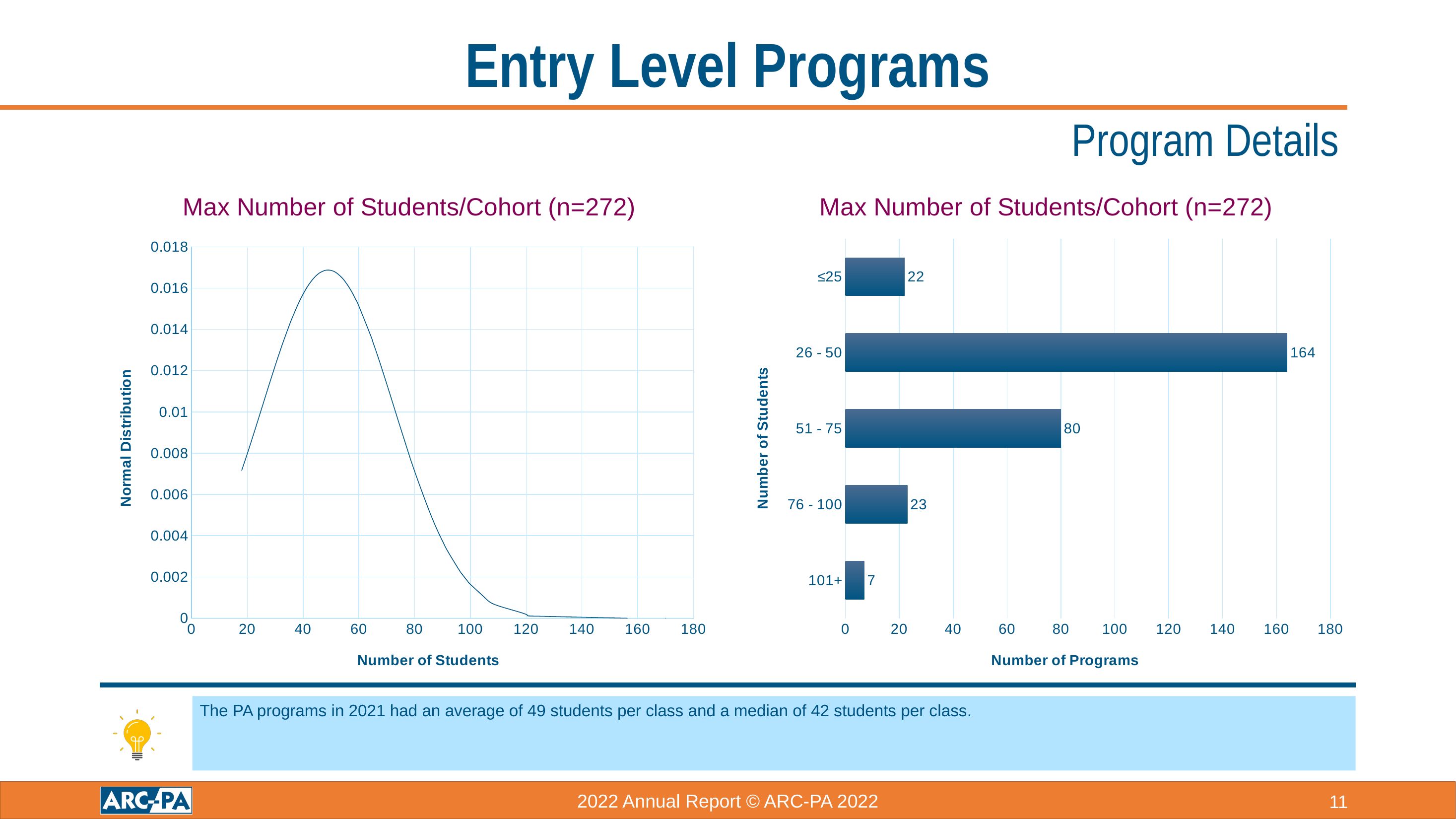
In the right-hand bar chart, which has more programs: the ≤25 category or the 76 - 100 category? 76 - 100 In the right-hand bar chart, how many programs have a max cohort size of 101+? 7 What kind of chart is the right-hand chart on the slide? bar chart In the right-hand bar chart, which cohort size category has the most programs? 26 - 50 In the right-hand bar chart, how many programs have a max cohort size of 51 - 75? 80 In the right-hand bar chart, what is the difference between the number of programs in the 26 - 50 category and the 51 - 75 category? 84 In the right-hand bar chart, how many programs have a max cohort size of 26 - 50? 164 In the right-hand bar chart, which cohort size category has the fewest programs? 101+ How many cohort size categories are shown in the right-hand bar chart? 5 What kind of chart is the left-hand chart on the slide? line chart In the left-hand line chart, is the value at 100 students greater or less than 0.004? less What is the x-axis label of the right-hand bar chart? Number of Programs